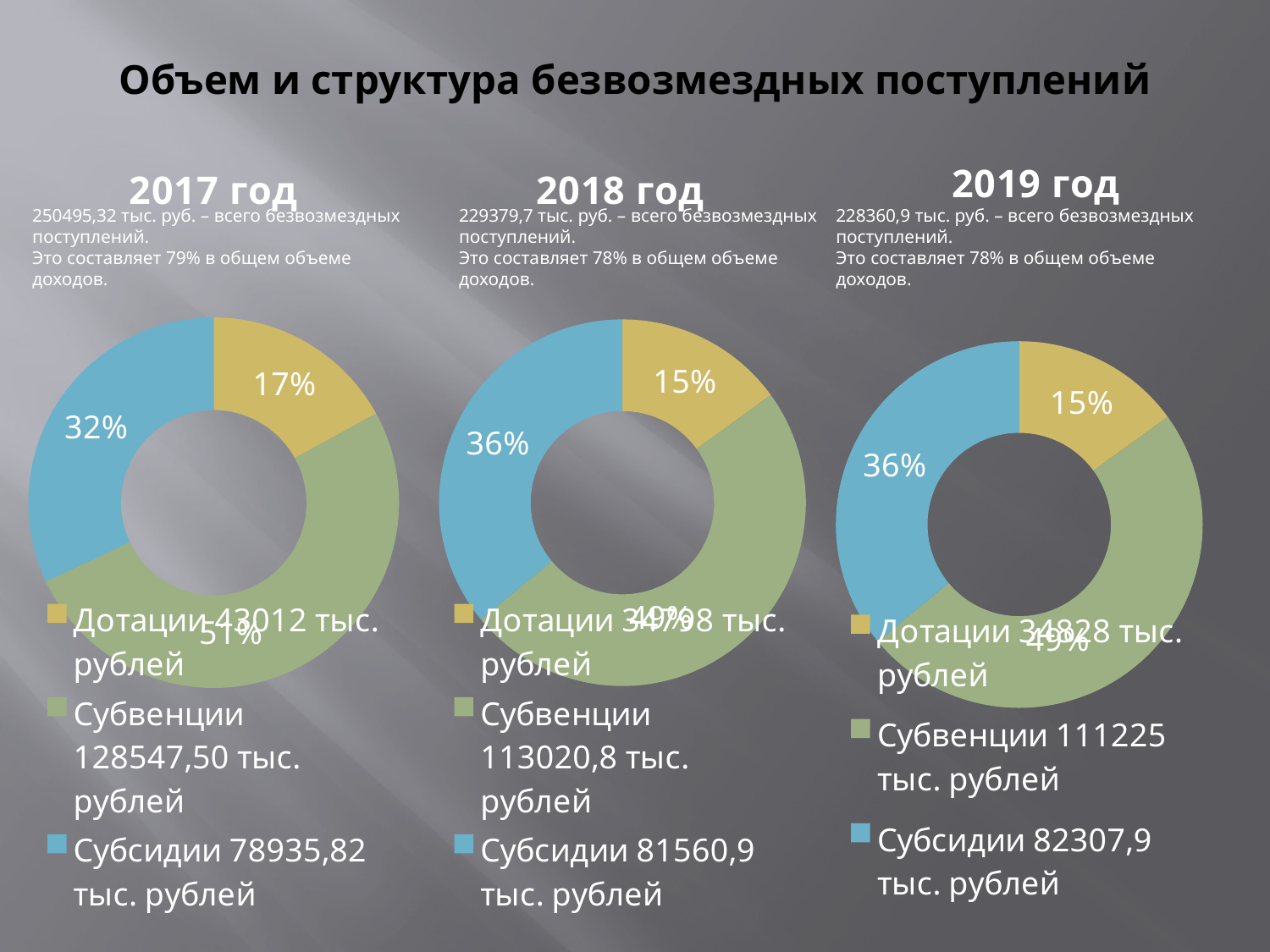
In the 2017 год chart, what share does Дотации have? 17% In the 2018 год chart, what share does Субсидии have? 36% How many categories does the legend of the 2019 год chart list? 3 What colour represents Субсидии in the charts? blue According to the legend of the 2017 год chart, what is the value for Субвенции? 128547,50 тыс. рублей In the 2017 год chart, what share does Субвенции have? 51% According to the legend of the 2019 год chart, what is the value for Субсидии? 82307,9 тыс. рублей In the 2017 год chart, which is larger: the share of Субсидии or the share of Дотации? Субсидии In the 2019 год chart, which category has the largest share? Субвенции What kind of chart is used for the 2017 год data? doughnut chart In the 2017 год chart, what is the difference in percentage points between the Субвенции share and the Субсидии share? 19 In the 2018 год chart, which category has the smallest share? Дотации